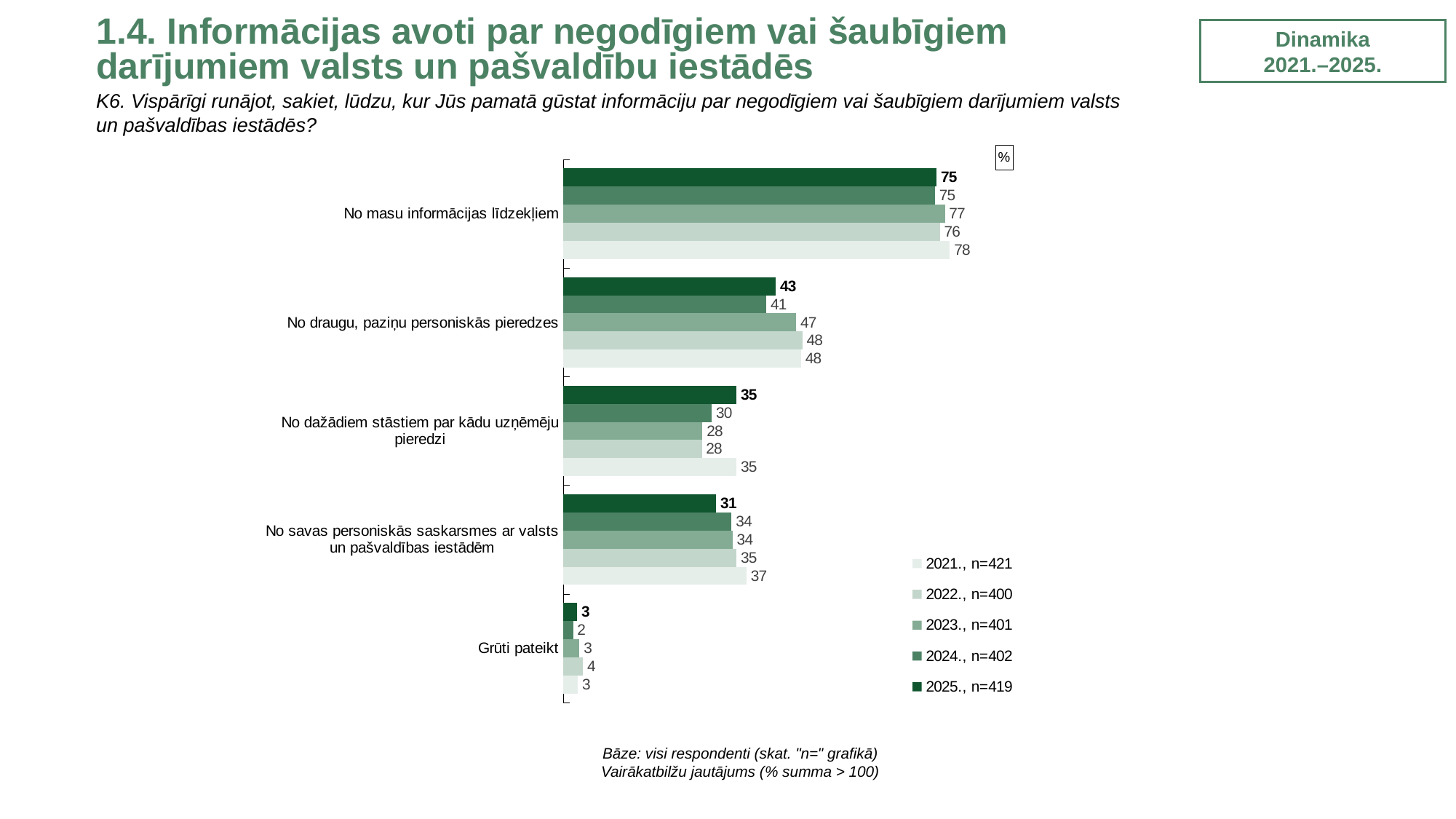
How many categories are shown on the chart? 5 What kind of chart is shown on the slide? bar chart What is the 2021 value for "No draugu, paziņu personiskās pieredzes"? 48 Which category has the highest 2025 value? No masu informācijas līdzekļiem What is the 2024 value for "No dažādiem stāstiem par kādu uzņēmēju pieredzi"? 30 How many series does the legend list? 5 What is the sample size (n) shown in the legend for 2025? n=419 What is the 2022 value for "Grūti pateikt"? 4 What is the difference between the 2025 and 2024 values for "No draugu, paziņu personiskās pieredzes"? 2 What is the 2025 value for "No masu informācijas līdzekļiem"? 75 For "No savas personiskās saskarsmes ar valsts un pašvaldības iestādēm", which is larger: the 2021 value or the 2025 value? 2021 Which category has the lowest 2023 value? Grūti pateikt